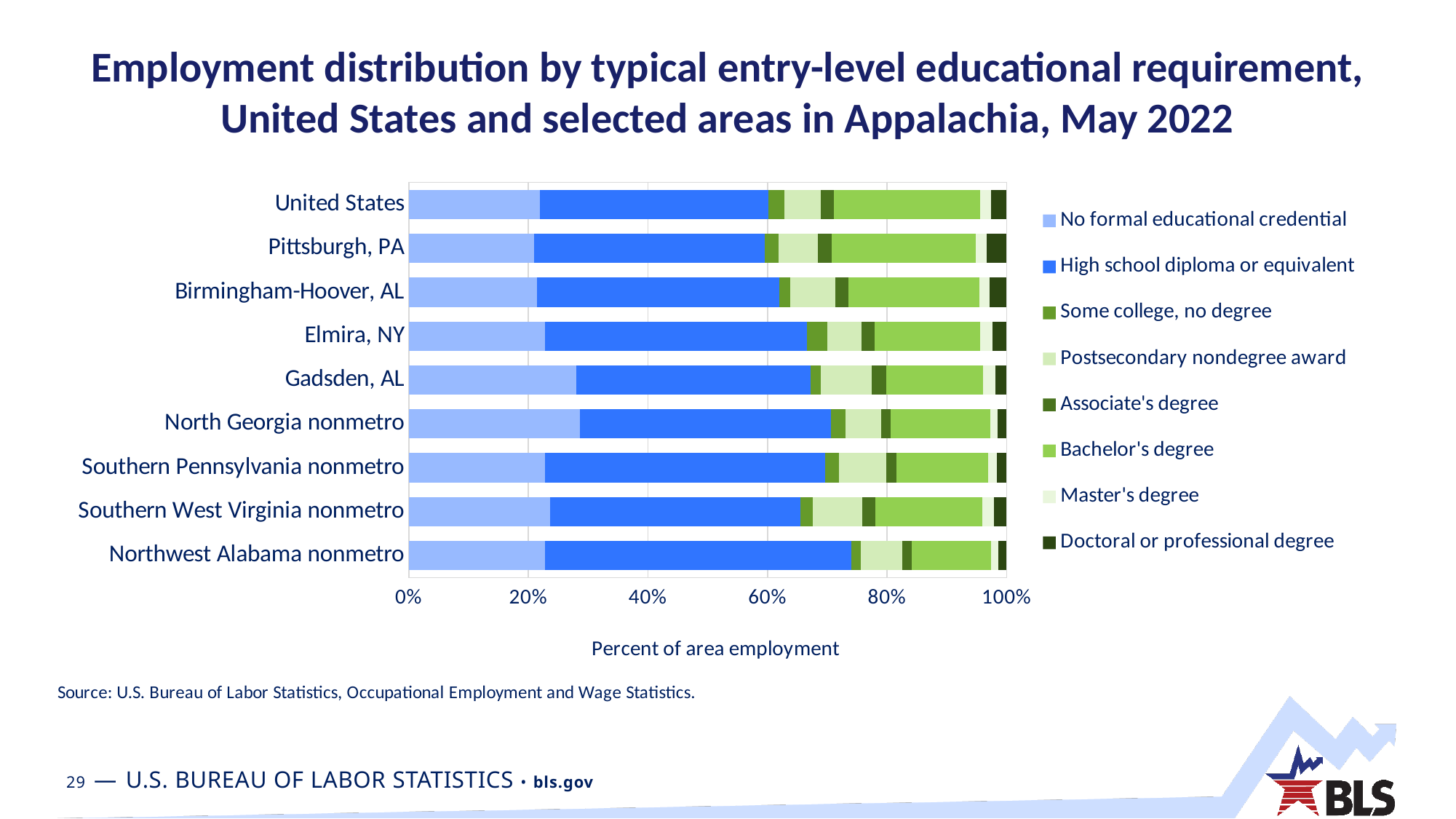
Which series is shown in the first (leftmost) segment of each bar? No formal educational credential Is the 'No formal educational credential' share for the United States greater or less than 20%? greater Is the 'No formal educational credential' share for Gadsden, AL greater or less than 20%? greater Which has a larger 'No formal educational credential' share, Gadsden, AL or the United States? Gadsden, AL Which has a larger 'Bachelor's degree' share, the United States or Northwest Alabama nonmetro? United States How many educational requirement series does the legend list? 8 What kind of chart is shown on the slide? Stacked bar chart How many areas (categories) are plotted on the chart? 9 Which has a larger 'No formal educational credential' share, North Georgia nonmetro or Pittsburgh, PA? North Georgia nonmetro What is the highest value shown on the horizontal axis? 100% What is the label of the horizontal axis? Percent of area employment Is the 'No formal educational credential' share for Northwest Alabama nonmetro greater or less than 40%? less